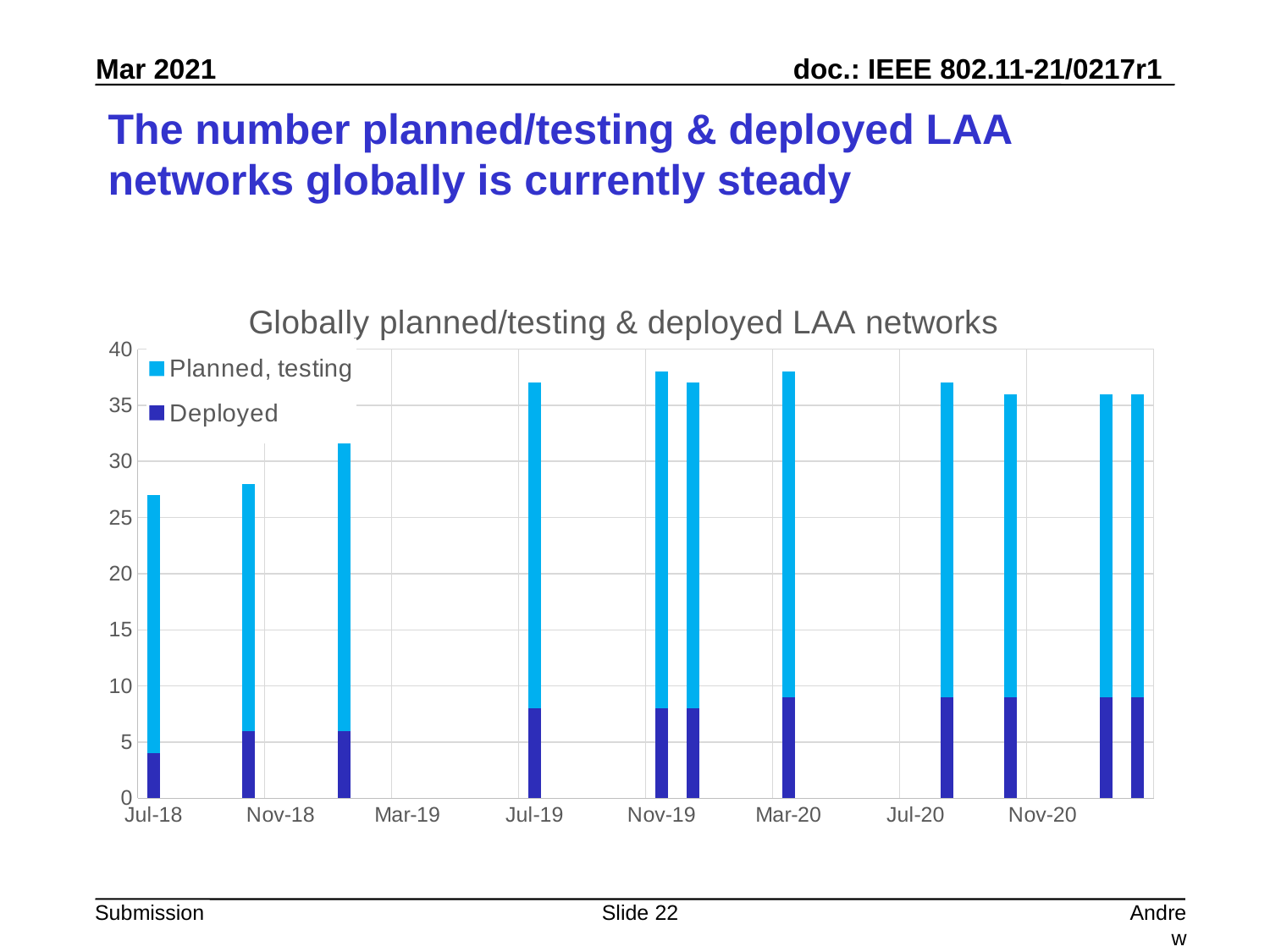
What is the highest value shown on the vertical axis? 40 Which is larger, the total value at Jul-18 or the total value at Jul-19? Jul-19 Is the total value of the bar at Jul-18 greater or less than 30? less Which series is shown in dark blue in the legend? Deployed What is the title of the chart? Globally planned/testing & deployed LAA networks Is the total value of the bar at Jul-19 greater or less than 35? greater Is the Deployed value at Mar-20 greater or less than 5? greater What kind of chart is shown on the slide? stacked bar chart How many series does the legend list? 2 Which bar has the lowest total value? Jul-18 Do the total values rise or fall from Jul-18 to Jul-19? rise